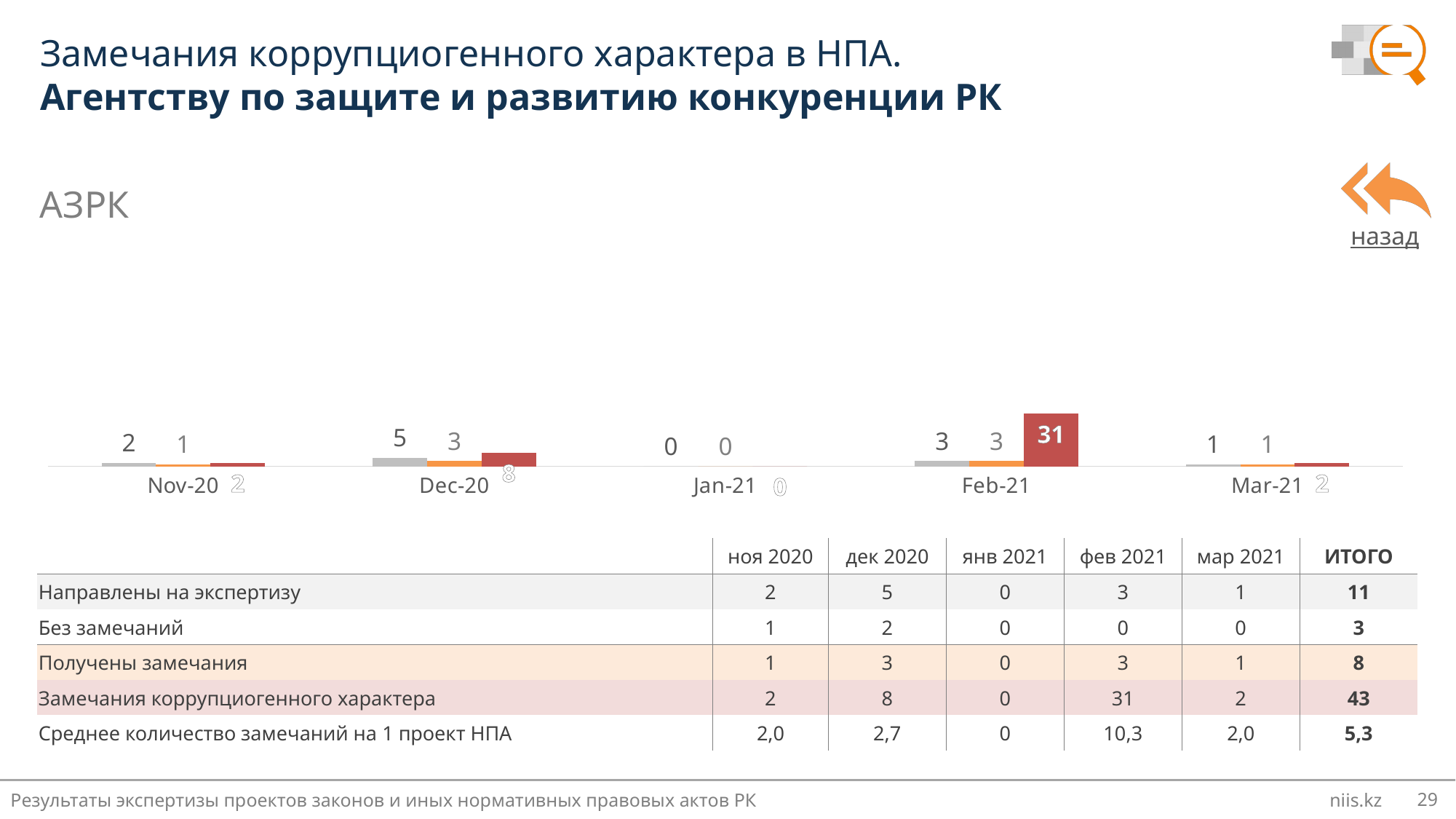
Which month has the highest red bar? Feb-21 What is the value of the red bar for Dec-20? 8 What is the difference between the red bar values for Feb-21 and Dec-20? 23 What is the value of the red bar for Feb-21? 31 How many month categories are shown on the x axis of the chart? 5 What is the value of the grey bar for Dec-20? 5 What type of chart is shown on the slide? bar chart What is the value of the orange bar for Feb-21? 3 Which month has the highest grey bar? Dec-20 What is the value of the orange bar for Mar-21? 1 Which is larger: the grey bar for Nov-20 or the grey bar for Feb-21? Feb-21 What is the value of the grey bar for Jan-21? 0